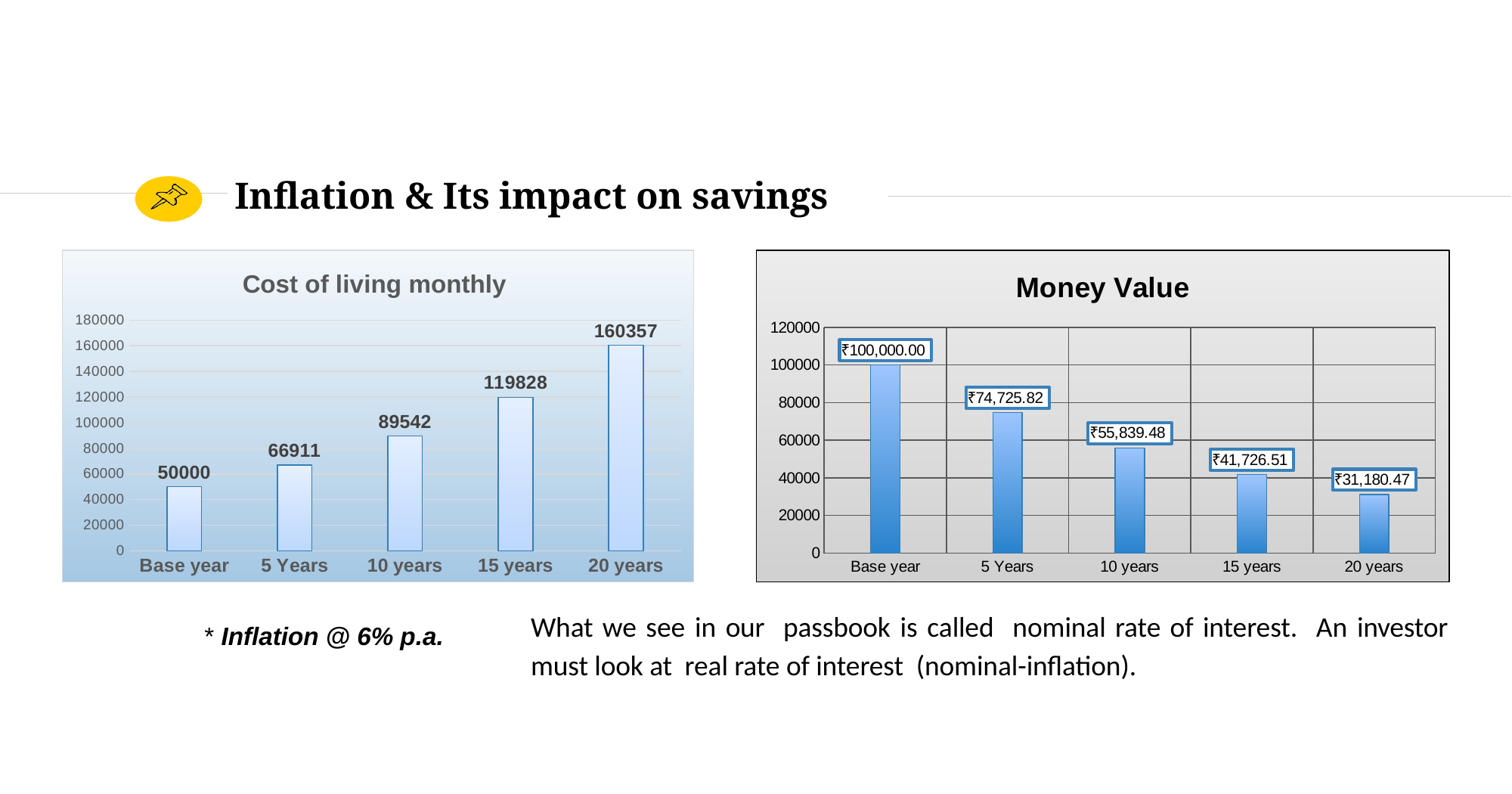
In the 'Money Value' chart, what is the value for 5 Years? ₹74,725.82 In the 'Cost of living monthly' chart, do the values rise or fall from Base year to 20 years? rise In the 'Money Value' chart, which category has the highest value? Base year In the 'Cost of living monthly' chart, what is the value for 10 years? 89542 In the 'Money Value' chart, which is larger: the value for 10 years or the value for 15 years? 10 years In the 'Cost of living monthly' chart, what is the value for 20 years? 160357 In the 'Cost of living monthly' chart, how many categories are shown on the x axis? 5 In the 'Money Value' chart, what is the value for 20 years? ₹31,180.47 What kind of chart is the 'Money Value' chart? bar chart In the 'Money Value' chart, do the values rise or fall from Base year to 20 years? fall In the 'Cost of living monthly' chart, which category has the lowest value? Base year In the 'Cost of living monthly' chart, what is the difference between the 15 years and 5 Years values? 52917